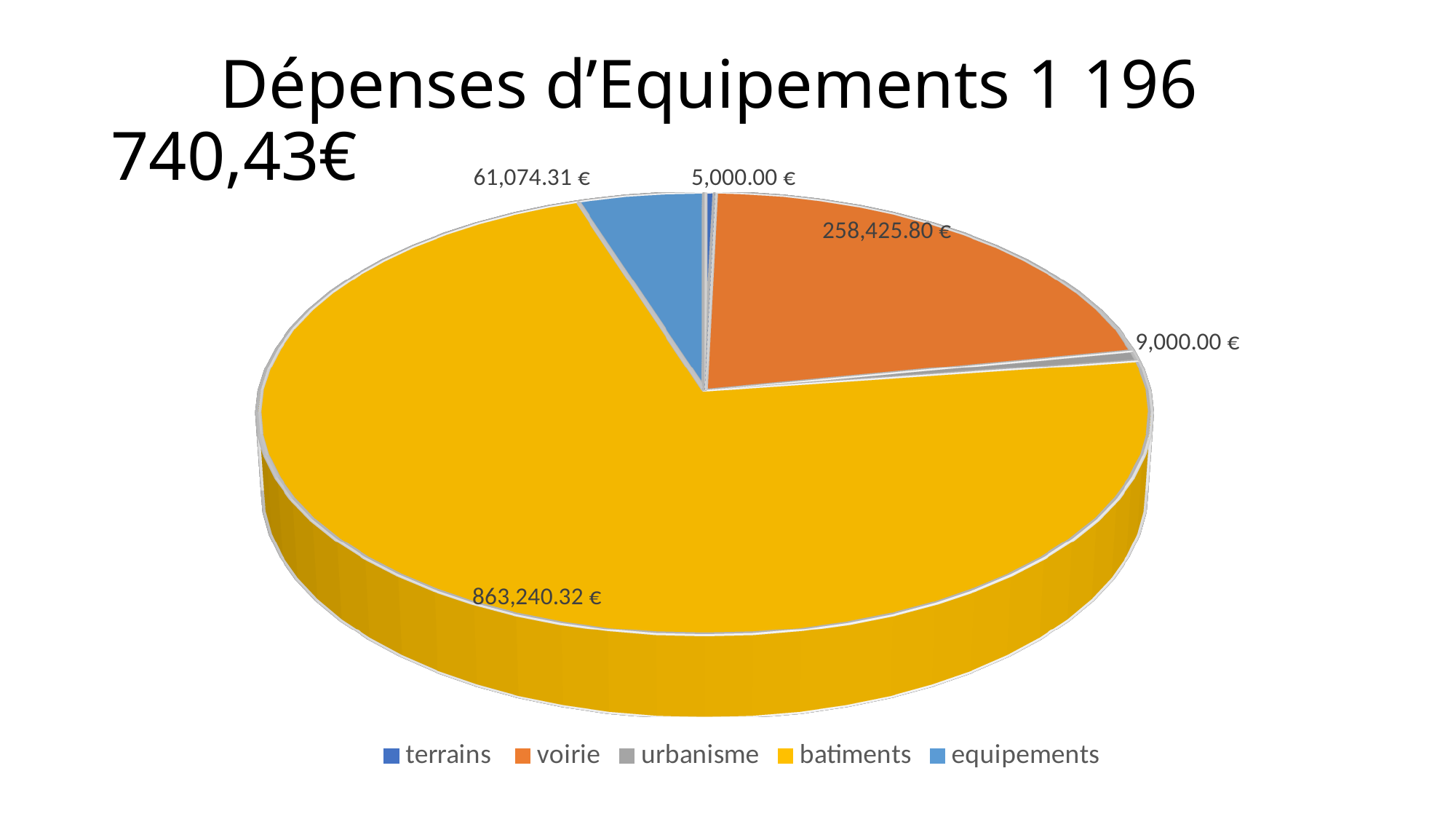
Which is larger, the value for voirie or the value for equipements? voirie What is the value for batiments? 863,240.32 € What is the value for urbanisme? 9,000.00 € What is the difference between the values for batiments and voirie? 604,814.52 € Which category has the largest slice of the pie? batiments How many categories does the legend list? 5 What is the difference between the values for equipements and urbanisme? 52,074.31 € What is the value for voirie? 258,425.80 € What is the value for terrains? 5,000.00 € Which category has the smallest slice of the pie? terrains What is the value for equipements? 61,074.31 € What type of chart is shown on the slide? pie chart